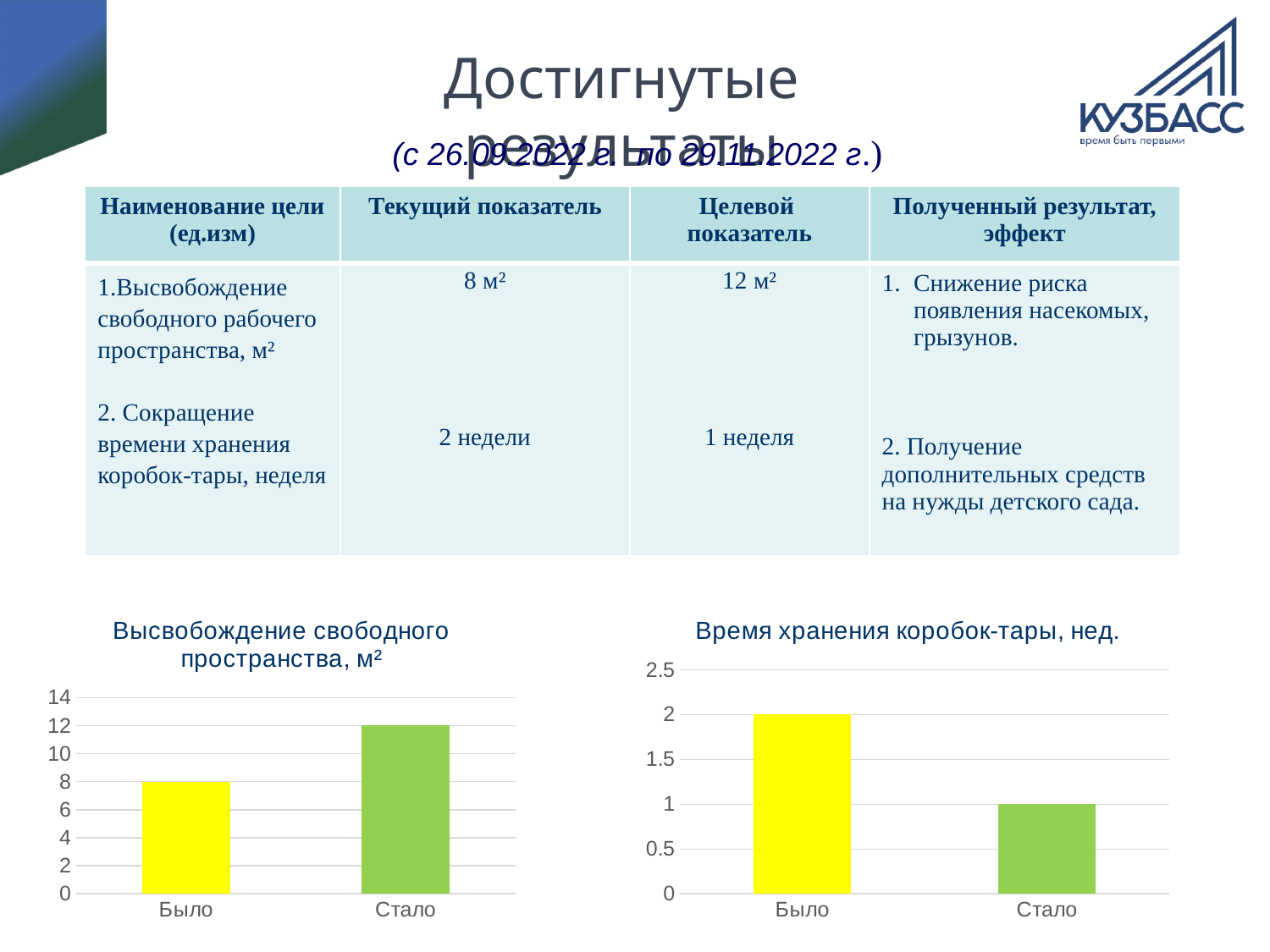
In the chart titled 'Высвобождение свободного пространства, м²', what is the value for Было? 8 In the chart titled 'Высвобождение свободного пространства, м²', which category has the highest value? Стало In the chart titled 'Время хранения коробок-тары, нед.', do the values rise or fall from Было to Стало? fall In the chart titled 'Время хранения коробок-тары, нед.', is the value for Было larger or smaller than the value for Стало? larger What kind of chart is the chart titled 'Время хранения коробок-тары, нед.'? bar chart In the chart titled 'Высвобождение свободного пространства, м²', what is the difference between Стало and Было? 4 In the chart titled 'Высвобождение свободного пространства, м²', what colour is the bar for Было? yellow In the chart titled 'Высвобождение свободного пространства, м²', how many categories are shown on the x axis? 2 In the chart titled 'Высвобождение свободного пространства, м²', what is the value for Стало? 12 In the chart titled 'Время хранения коробок-тары, нед.', what is the value for Стало? 1 In the chart titled 'Время хранения коробок-тары, нед.', which category has the lowest value? Стало In the chart titled 'Время хранения коробок-тары, нед.', what is the value for Было? 2